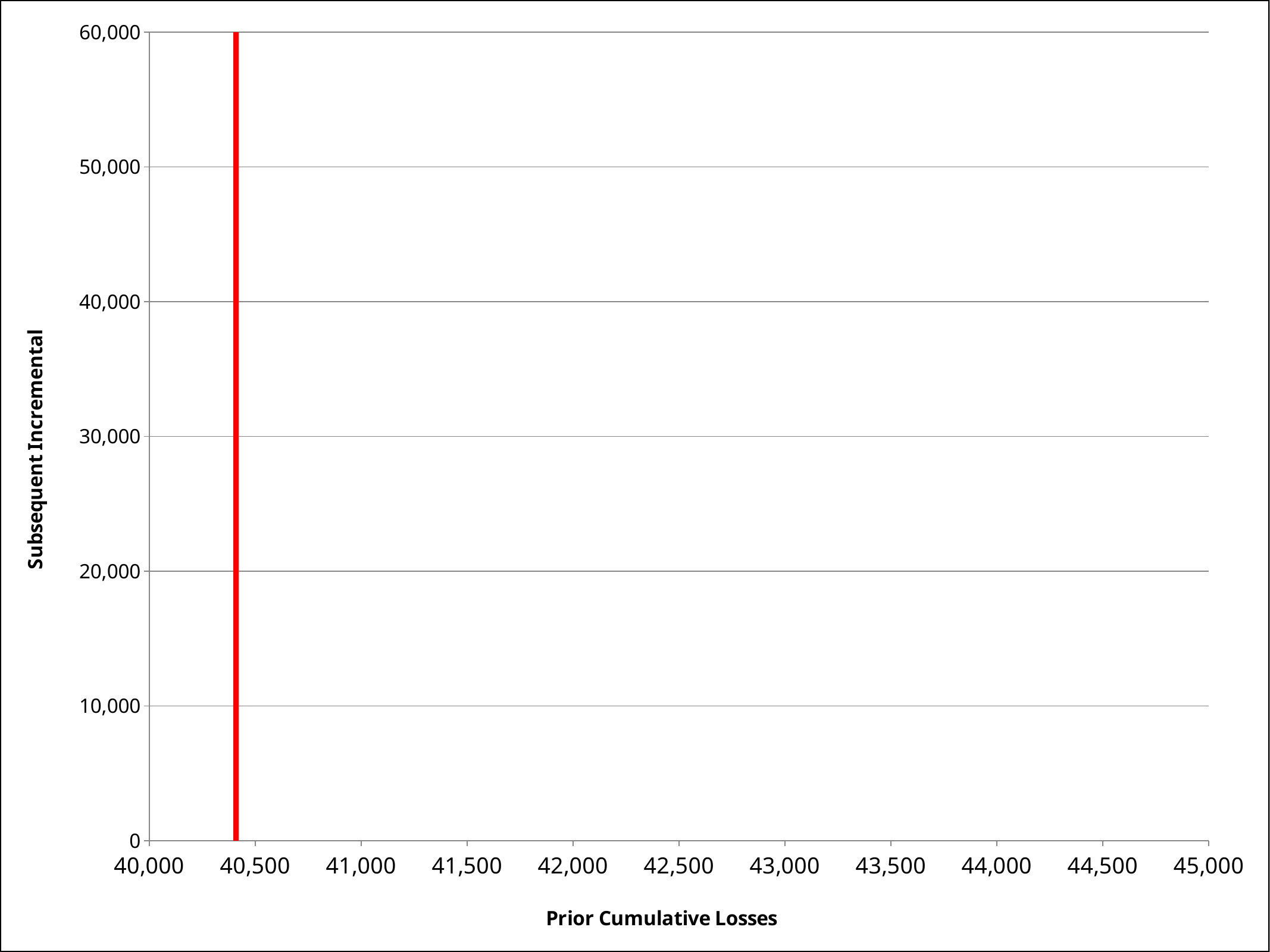
What is the highest value shown on the Subsequent Incremental axis? 60,000 Is the red line's position on the Prior Cumulative Losses axis greater or less than 41,000? less What is the title of the horizontal axis? Prior Cumulative Losses What is the title of the vertical axis? Subsequent Incremental Is the red line's position on the Prior Cumulative Losses axis greater or less than 40,500? less How many red vertical lines are plotted on the chart? 1